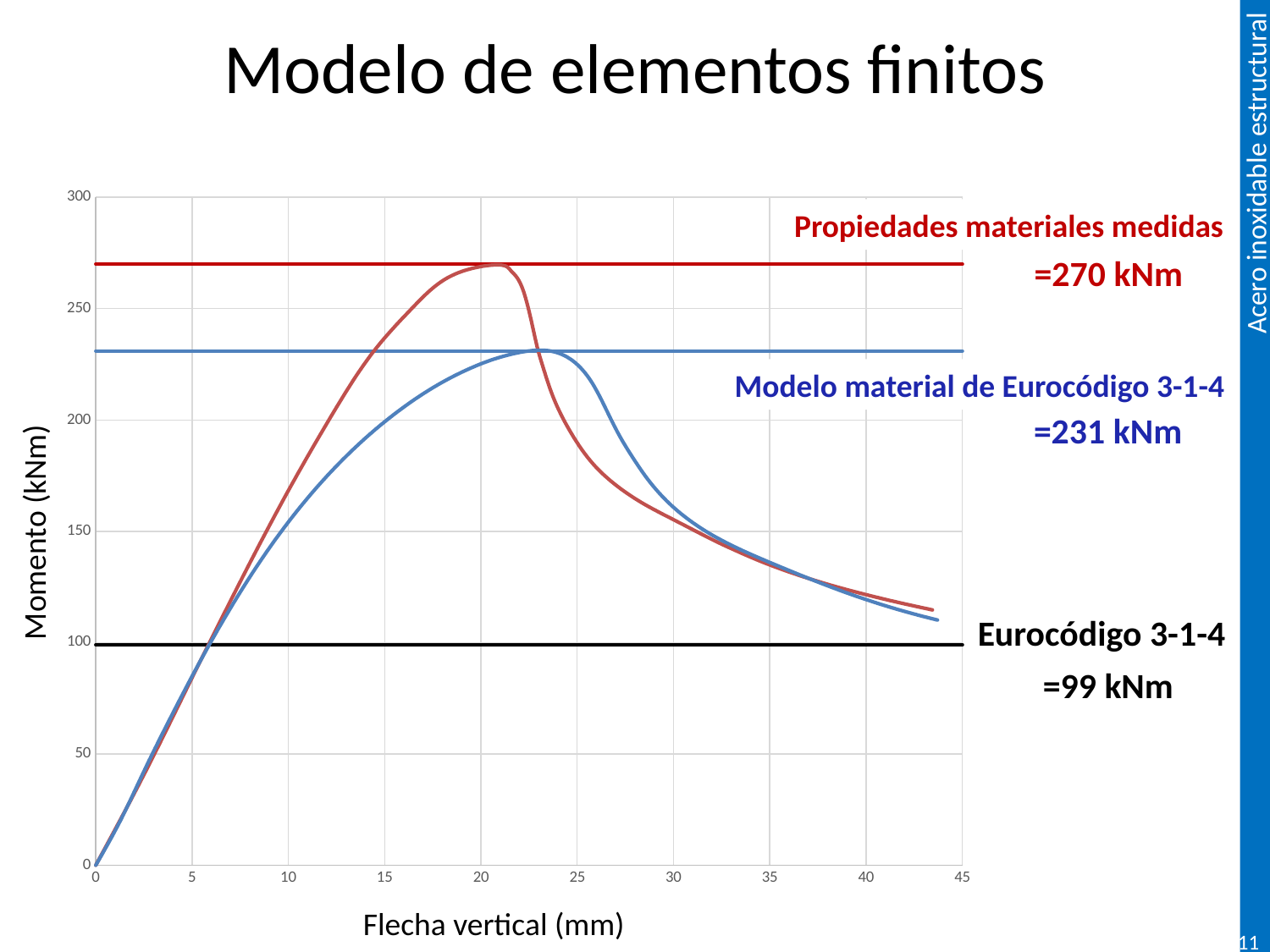
What moment value is labelled for the 'Eurocódigo 3-1-4' line? 99 kNm Which of the three labelled horizontal reference lines has the lowest moment value? Eurocódigo 3-1-4 What is the difference between the 'Modelo material de Eurocódigo 3-1-4' value and the 'Eurocódigo 3-1-4' value? 132 kNm What moment value is labelled for the 'Propiedades materiales medidas' line? 270 kNm What moment value is labelled for the 'Modelo material de Eurocódigo 3-1-4' line? 231 kNm Is the peak of the red curve greater or less than 250 kNm? greater Is the peak of the blue curve greater or less than 250 kNm? less After reaching its peak, does the red curve rise or fall as the vertical deflection increases? fall What kind of chart is shown on the slide? line chart Which of the three labelled horizontal reference lines has the highest moment value? Propiedades materiales medidas What is the label of the x axis? Flecha vertical (mm) What is the difference between the 'Propiedades materiales medidas' value and the 'Modelo material de Eurocódigo 3-1-4' value? 39 kNm